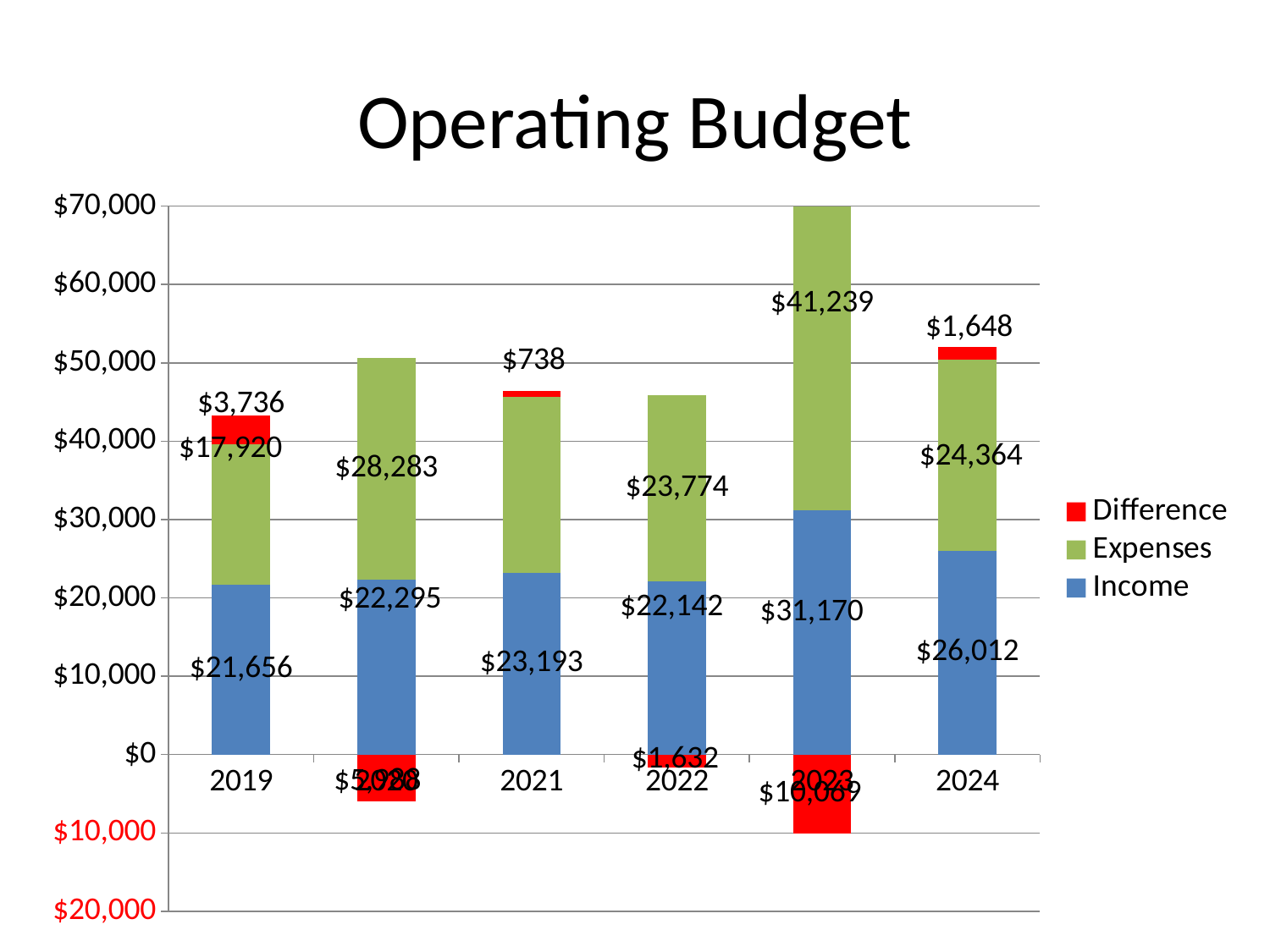
What is the Expenses value for 2023? $41,239 How many series does the legend list? 3 What is the Difference value for 2024? $1,648 What is the Income value for 2019? $21,656 What kind of chart is shown on the slide? Stacked bar chart Which year has the lowest Income? 2019 Which year has the highest Expenses? 2023 What is the difference between the Income for 2023 and the Income for 2024? $5,158 What colour represents the Difference series in the legend? Red Which year has the larger Income, 2022 or 2024? 2024 Which year has the highest Income? 2023 How many years are shown on the x axis? 6